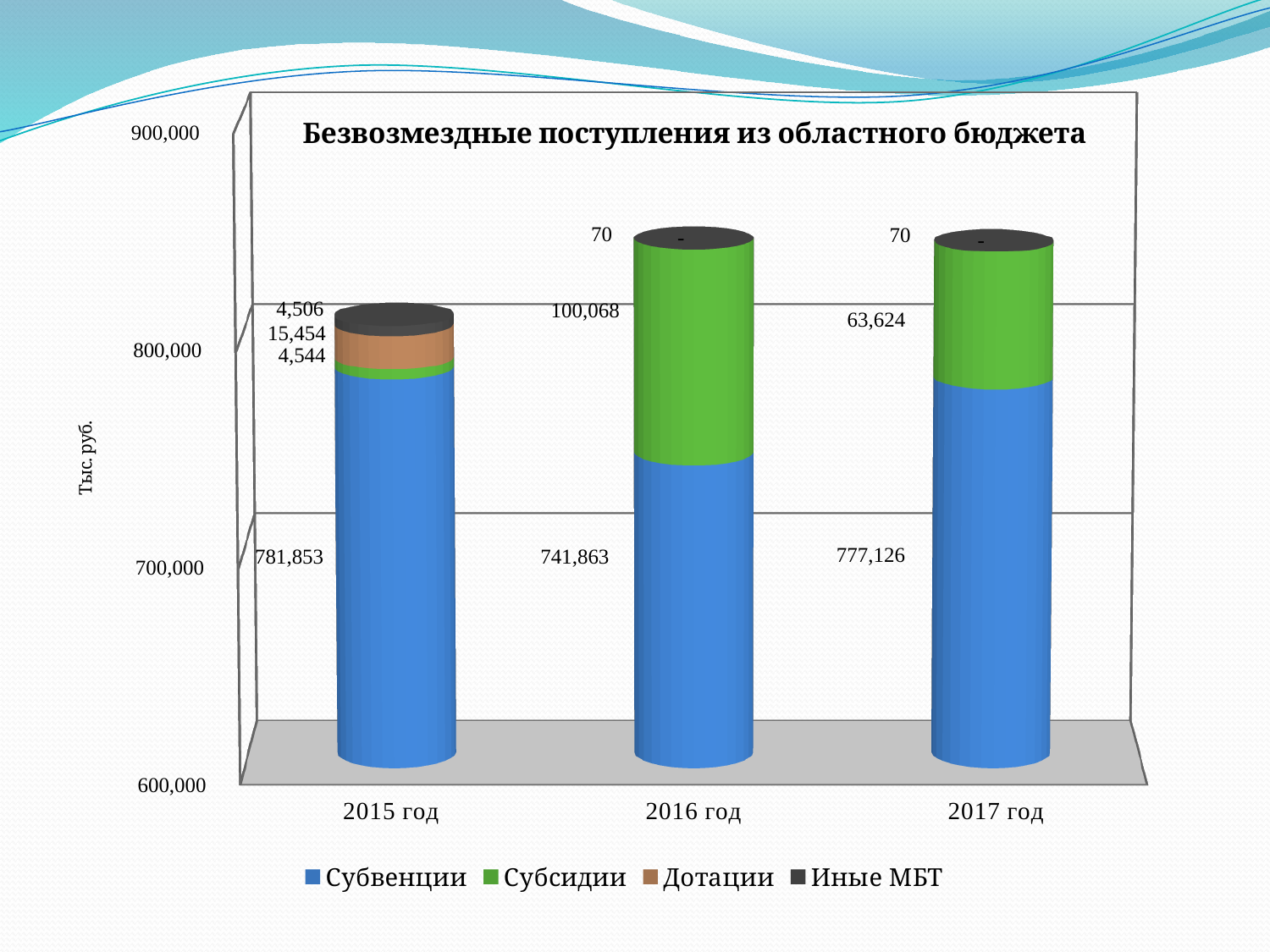
In which year is the Субвенции value the highest? 2015 год How many series does the legend list? 4 What is the value of Дотации for 2015 год? 15,454 What is the value of Субсидии for 2016 год? 100,068 What is the total of the stacked bar for 2015 год? 806,357 What is the value of Субвенции for 2015 год? 781,853 How many years are shown on the x axis? 3 What is the value of Иные МБТ for 2017 год? 70 In which year is the Субвенции value the lowest? 2016 год What is the difference between the Субвенции values for 2015 год and 2016 год? 39,990 What kind of chart is shown on the slide? Stacked bar chart Which is larger: Субсидии in 2016 год or Субсидии in 2017 год? 2016 год